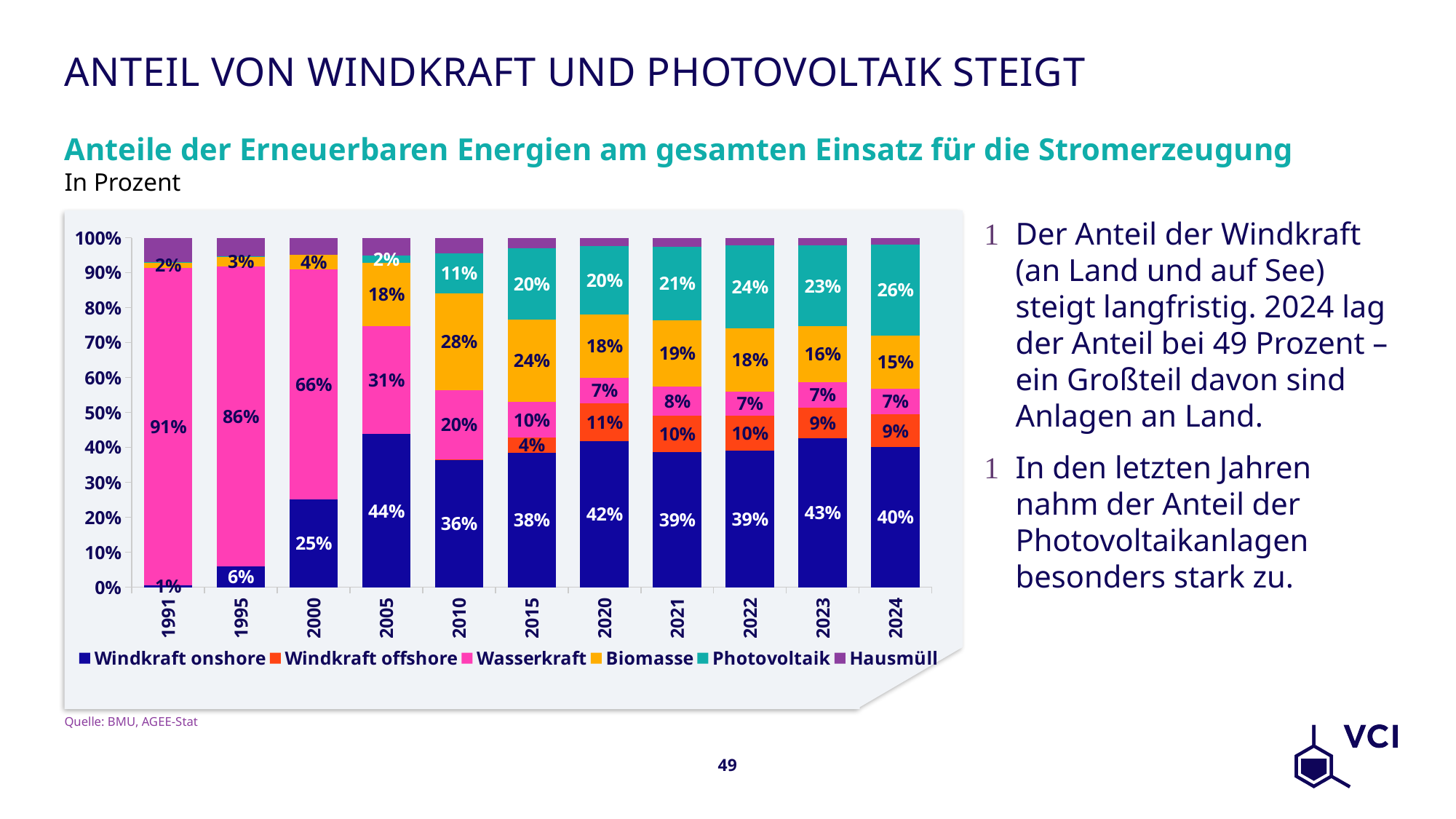
What is the share of Biomasse in 2010? 28% What kind of chart is shown on the slide? Stacked bar chart How many series does the legend list? 6 What is the share of Wasserkraft in 1991? 91% What is the difference between the Photovoltaik share in 2024 and in 2010? 15 percentage points Which is larger in 2015: the share of Biomasse or the share of Photovoltaik? Biomasse Does the share of Wasserkraft rise or fall from 1991 to 2024? Fall In which year is the share of Windkraft onshore highest? 2005 What is the share of Photovoltaik in 2024? 26% What is the share of Windkraft offshore in 2020? 11% How many years are shown on the x axis? 11